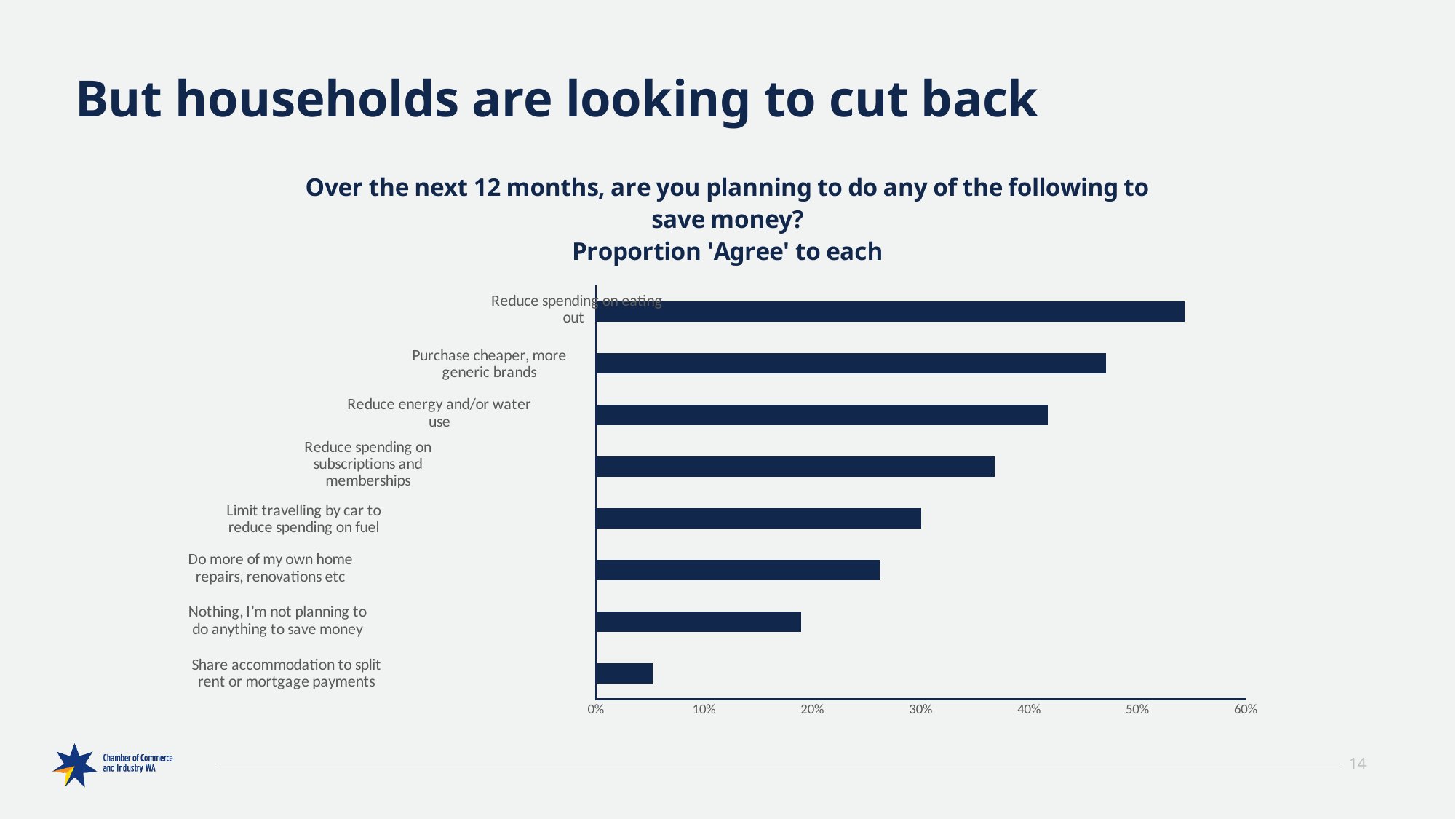
Is the value for 'Reduce spending on eating out' greater or less than 50%? greater Which is larger: the value for 'Reduce spending on eating out' or the value for 'Purchase cheaper, more generic brands'? Reduce spending on eating out How many categories are plotted in the chart? 8 Is the value for 'Share accommodation to split rent or mortgage payments' greater or less than 10%? less Is the value for 'Purchase cheaper, more generic brands' greater or less than 50%? less What is the maximum value shown on the chart's horizontal axis? 60% Which category has the lowest proportion of 'Agree' responses? Share accommodation to split rent or mortgage payments Which is larger: the value for 'Limit travelling by car to reduce spending on fuel' or the value for 'Nothing, I'm not planning to do anything to save money'? Limit travelling by car to reduce spending on fuel What kind of chart is shown on the slide? Bar chart Which category has the highest proportion of 'Agree' responses? Reduce spending on eating out